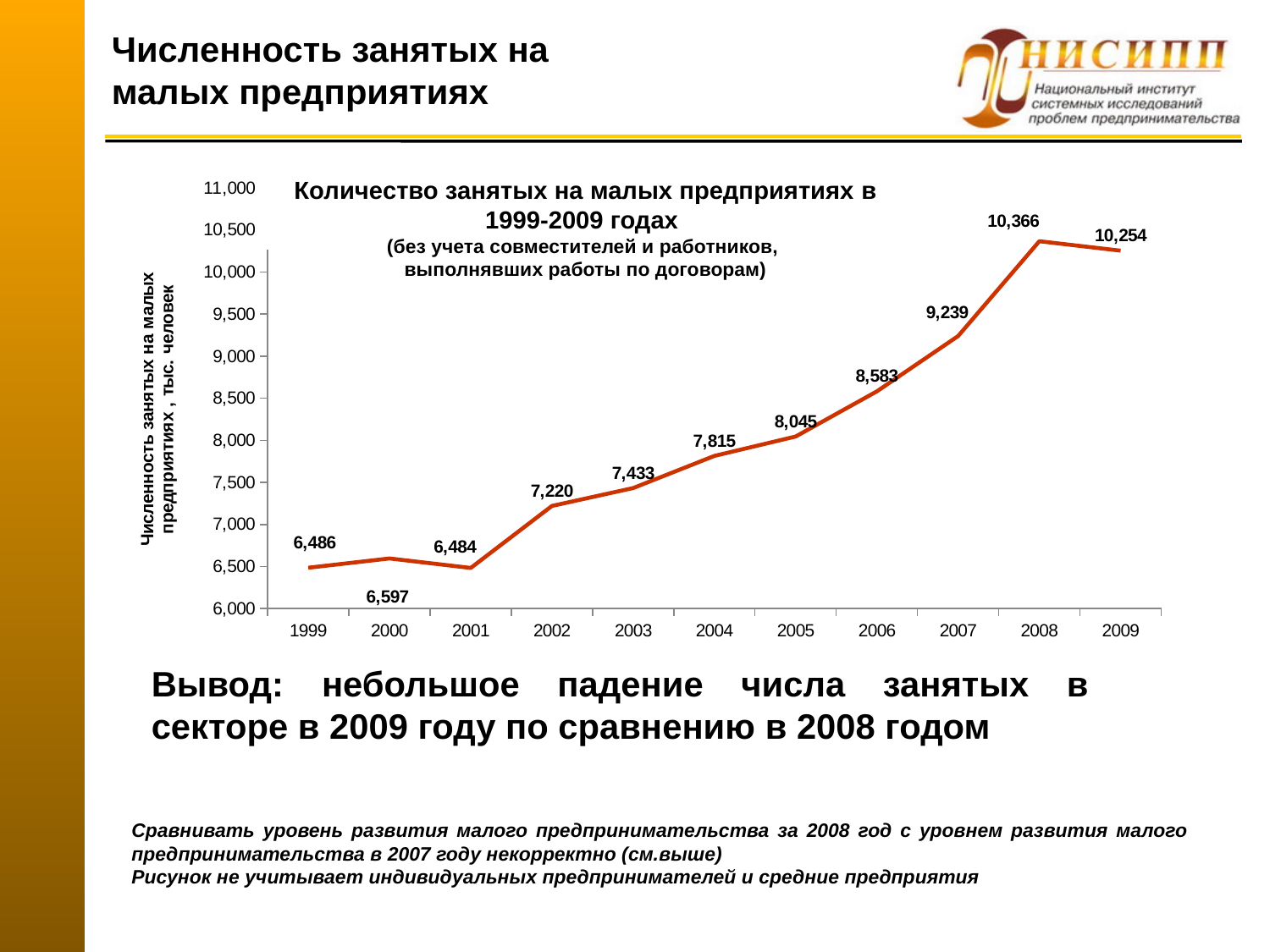
What is the difference between the values for 2007 and 2006? 656 Do the values generally rise or fall from 2001 to 2008? rise Which is larger, the value for 2005 or the value for 2004? 2005 How many years are plotted on the x axis? 11 Which year has the highest value? 2008 What kind of chart is shown? line chart What is the difference between the values for 2008 and 2009? 112 What is the value for 2002? 7,220 What is the value for 1999? 6,486 Which year has the lowest value? 2001 Is the value for 2006 greater or less than 8,500? greater What is the value for 2008? 10,366